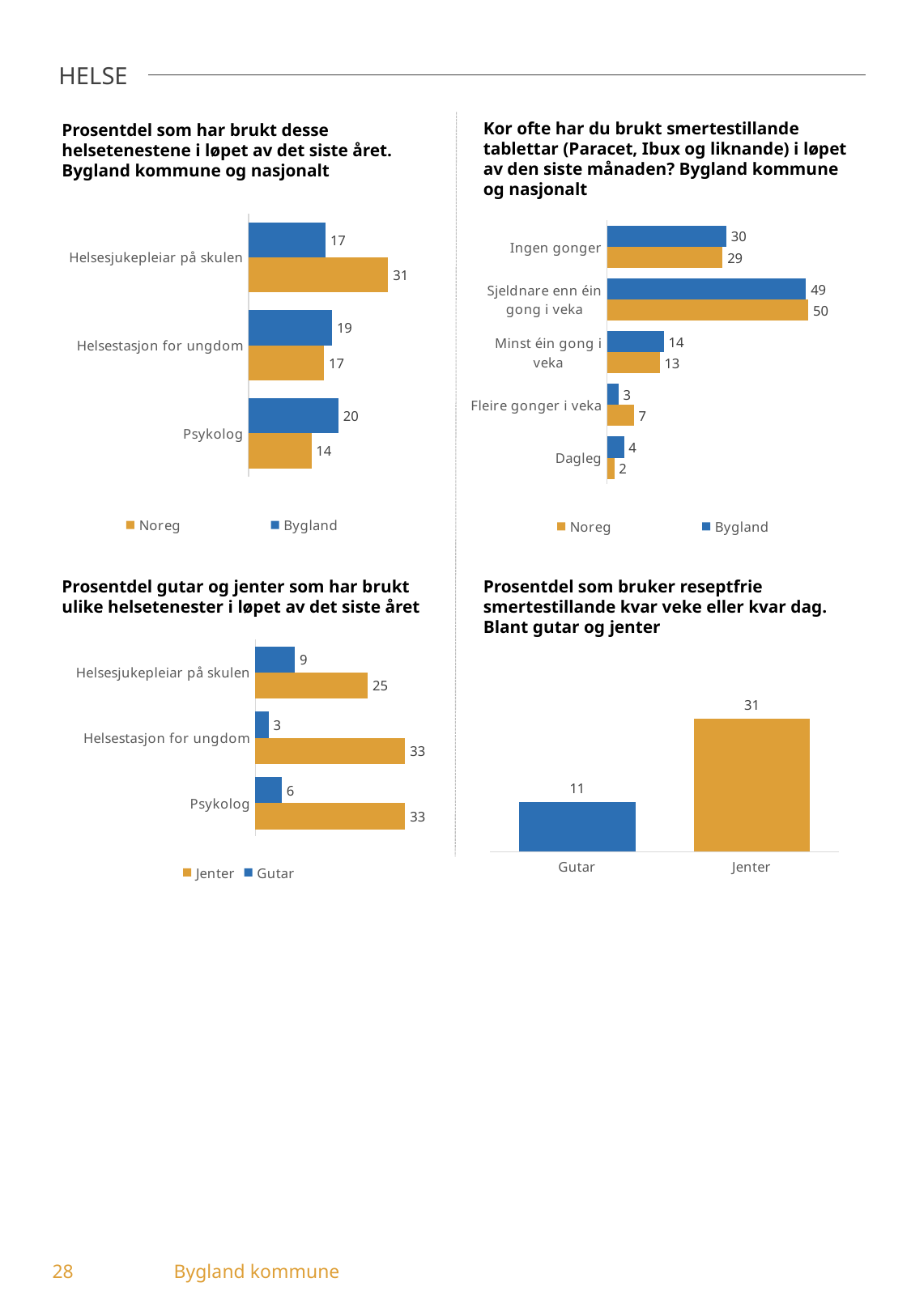
In the top-right chart (Kor ofte har du brukt smertestillande tablettar), which category has the lowest Noreg value? Dagleg In the top-left chart (Prosentdel som har brukt desse helsetenestene), what is the Bygland value for Psykolog? 20 In the top-right chart (Kor ofte har du brukt smertestillande tablettar), how many categories are shown? 5 In the top-right chart (Kor ofte har du brukt smertestillande tablettar), what is the Noreg value for Fleire gonger i veka? 7 In the top-left chart (Prosentdel som har brukt desse helsetenestene), what is the Noreg value for Helsesjukepleiar på skulen? 31 In the bottom-left chart (Prosentdel gutar og jenter som har brukt ulike helsetenester), which is larger for Psykolog, Jenter or Gutar? Jenter In the bottom-right chart (Prosentdel som bruker reseptfrie smertestillande kvar veke eller kvar dag), what is the value for Jenter? 31 In the bottom-left chart (Prosentdel gutar og jenter som har brukt ulike helsetenester), what is the Gutar value for Helsestasjon for ungdom? 3 What kind of chart is the bottom-right chart (Prosentdel som bruker reseptfrie smertestillande kvar veke eller kvar dag)? Bar chart In the top-right chart (Kor ofte har du brukt smertestillande tablettar), which category has the highest Bygland value? Sjeldnare enn éin gong i veka In the bottom-left chart (Prosentdel gutar og jenter som har brukt ulike helsetenester), how many series does the legend list? 2 In the top-left chart (Prosentdel som har brukt desse helsetenestene), what is the difference between the Noreg and Bygland values for Helsesjukepleiar på skulen? 14